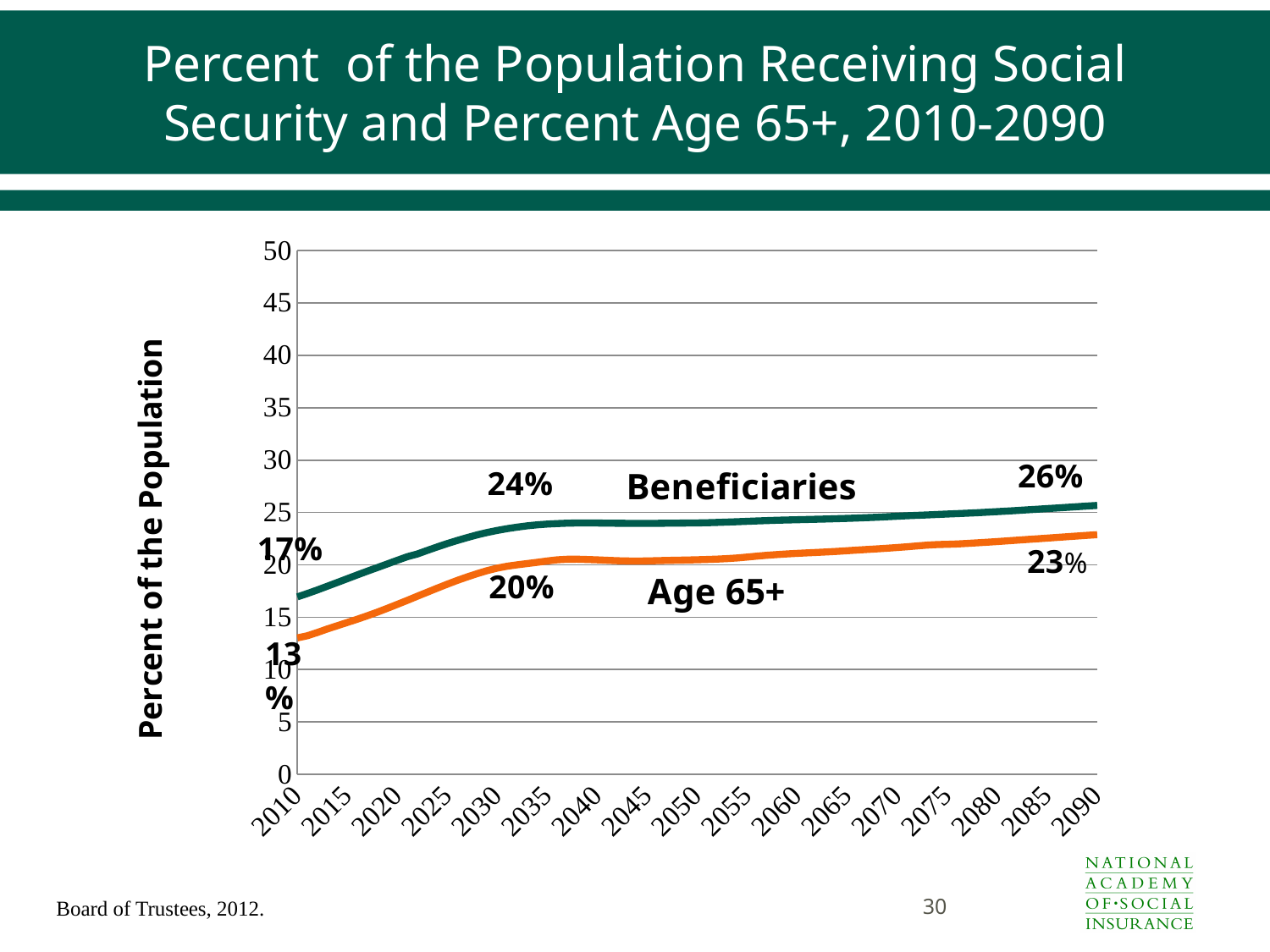
What is the value for Age 65+ in 2090? 23% Is the value for Beneficiaries in 2050 greater or less than 20? greater Which series has the higher value in 2090, Beneficiaries or Age 65+? Beneficiaries Do the Beneficiaries values rise or fall from 2010 to 2090? rise What is the difference between the Beneficiaries and Age 65+ values in 2090? 3% How many years are labelled on the x axis? 17 What is the value for Beneficiaries in 2090? 26% What is the difference between the Beneficiaries and Age 65+ values in 2010? 4% What is the value for Beneficiaries in 2010? 17% What is the title of the y axis? Percent of the Population What kind of chart is shown on the slide? line chart What is the value for Age 65+ in 2010? 13%